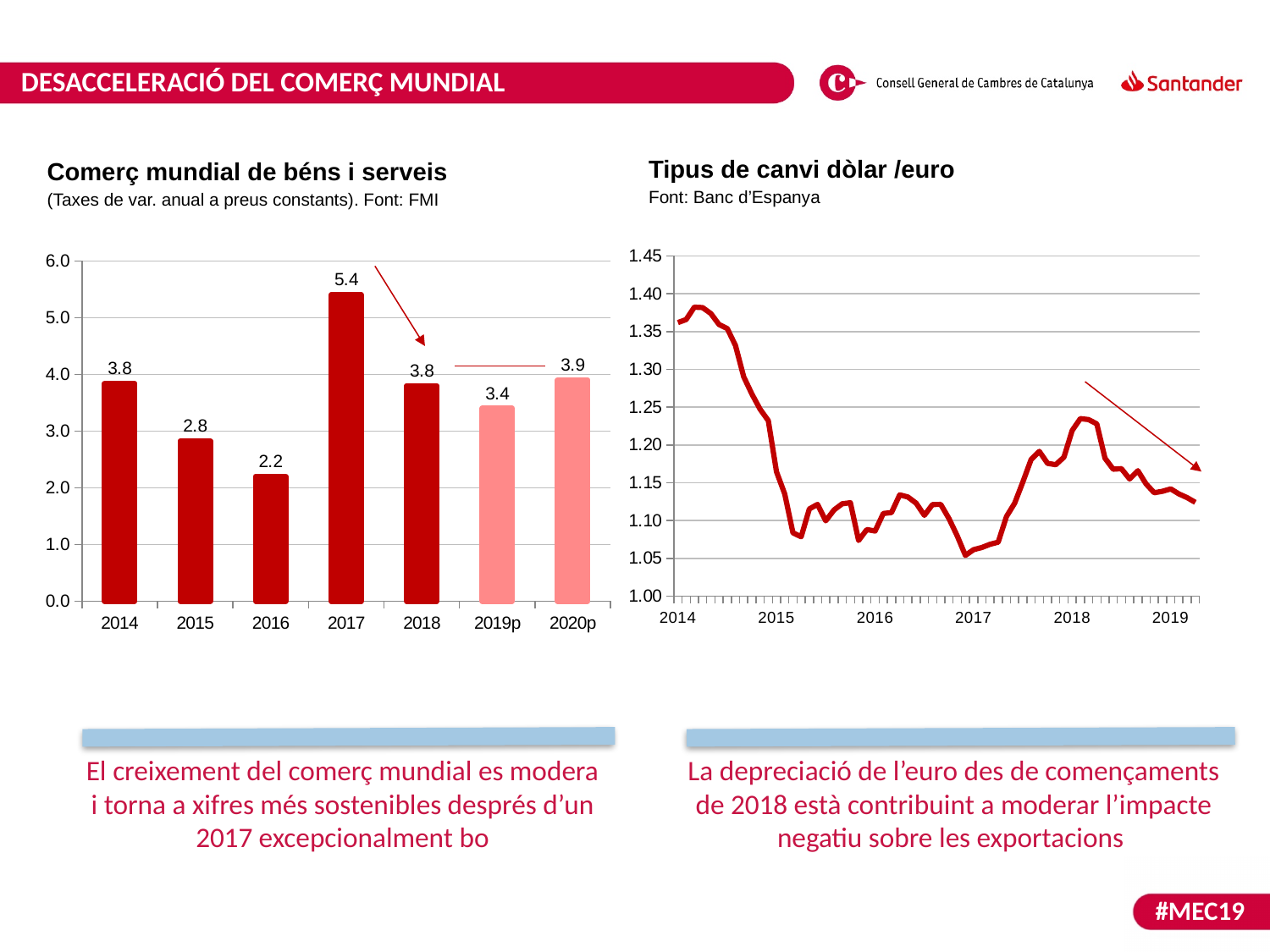
In the chart 'Comerç mundial de béns i serveis', which is larger, the value for 2015 or the value for 2020p? 2020p What kind of chart is 'Tipus de canvi dòlar /euro'? Line chart How many bars are shown in the chart 'Comerç mundial de béns i serveis'? 7 In the chart 'Comerç mundial de béns i serveis', do the values rise or fall from 2014 to 2016? Fall In the chart 'Tipus de canvi dòlar /euro', is the value at the start of 2014 greater or less than 1.30? greater In the chart 'Comerç mundial de béns i serveis', what is the value for 2019p? 3.4 What kind of chart is 'Comerç mundial de béns i serveis'? Bar chart In the chart 'Comerç mundial de béns i serveis', what is the difference between the values for 2017 and 2018? 1.6 In the chart 'Comerç mundial de béns i serveis', what is the value for 2017? 5.4 In the chart 'Comerç mundial de béns i serveis', which year has the highest value? 2017 In the chart 'Tipus de canvi dòlar /euro', does the line rise or fall from the start of 2018 to 2019? Fall In the chart 'Comerç mundial de béns i serveis', which year has the lowest value? 2016